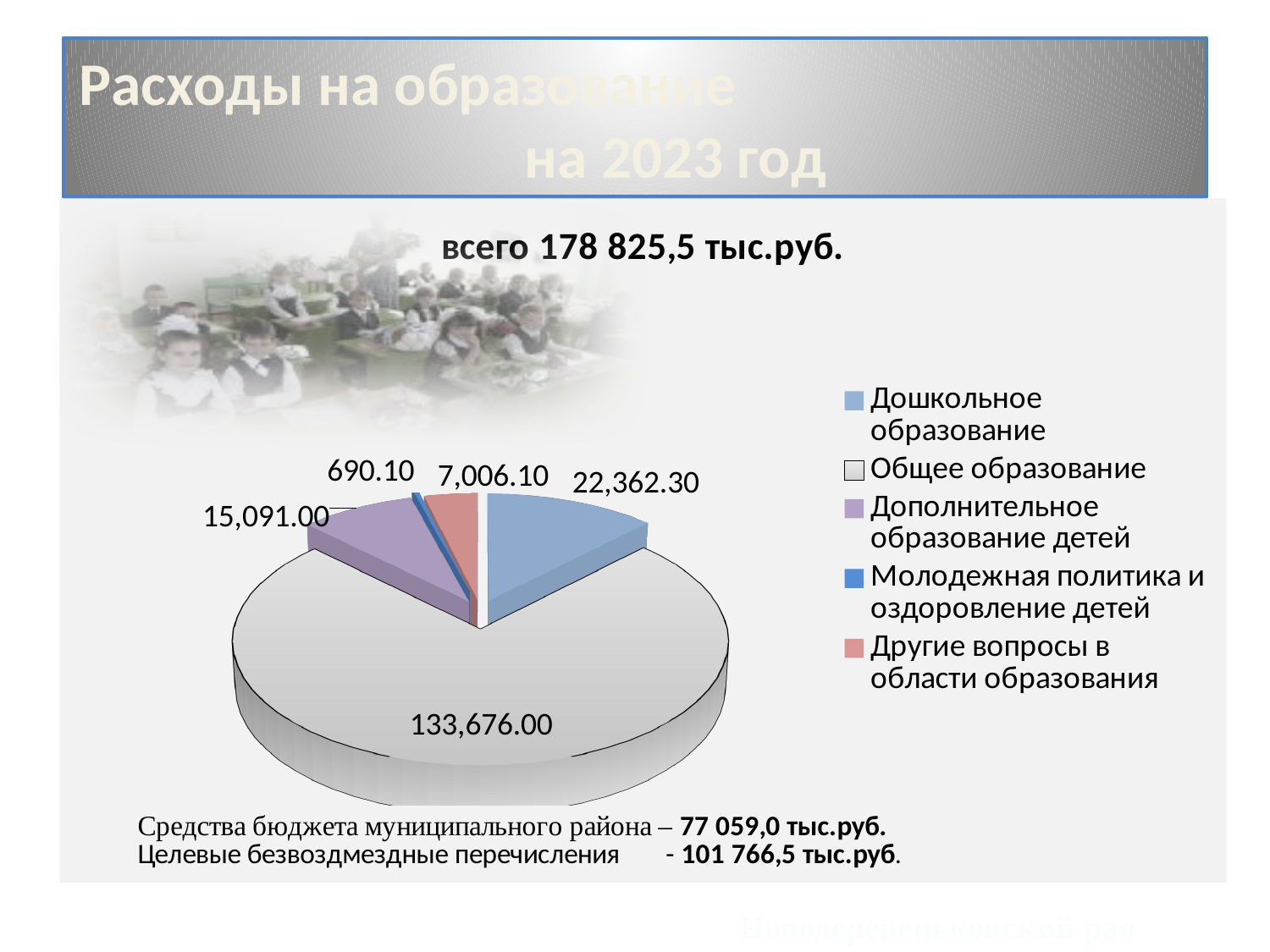
What is the value of the Молодежная политика и оздоровление детей slice? 690.10 What is the difference between the Общее образование and Дошкольное образование values? 111,313.70 What total amount is stated above the pie chart? 178 825,5 тыс.руб. How many slices does the pie chart have? 5 Which category has the smallest slice in the pie chart? Молодежная политика и оздоровление детей Which category has the largest slice in the pie chart? Общее образование What is the value of the Общее образование slice? 133,676.00 How many entries does the legend of the pie chart list? 5 Which is larger: Дополнительное образование детей or Другие вопросы в области образования? Дополнительное образование детей What type of chart is shown on the slide? Pie chart What is the value of the Дополнительное образование детей slice? 15,091.00 What is the value of the Дошкольное образование slice? 22,362.30